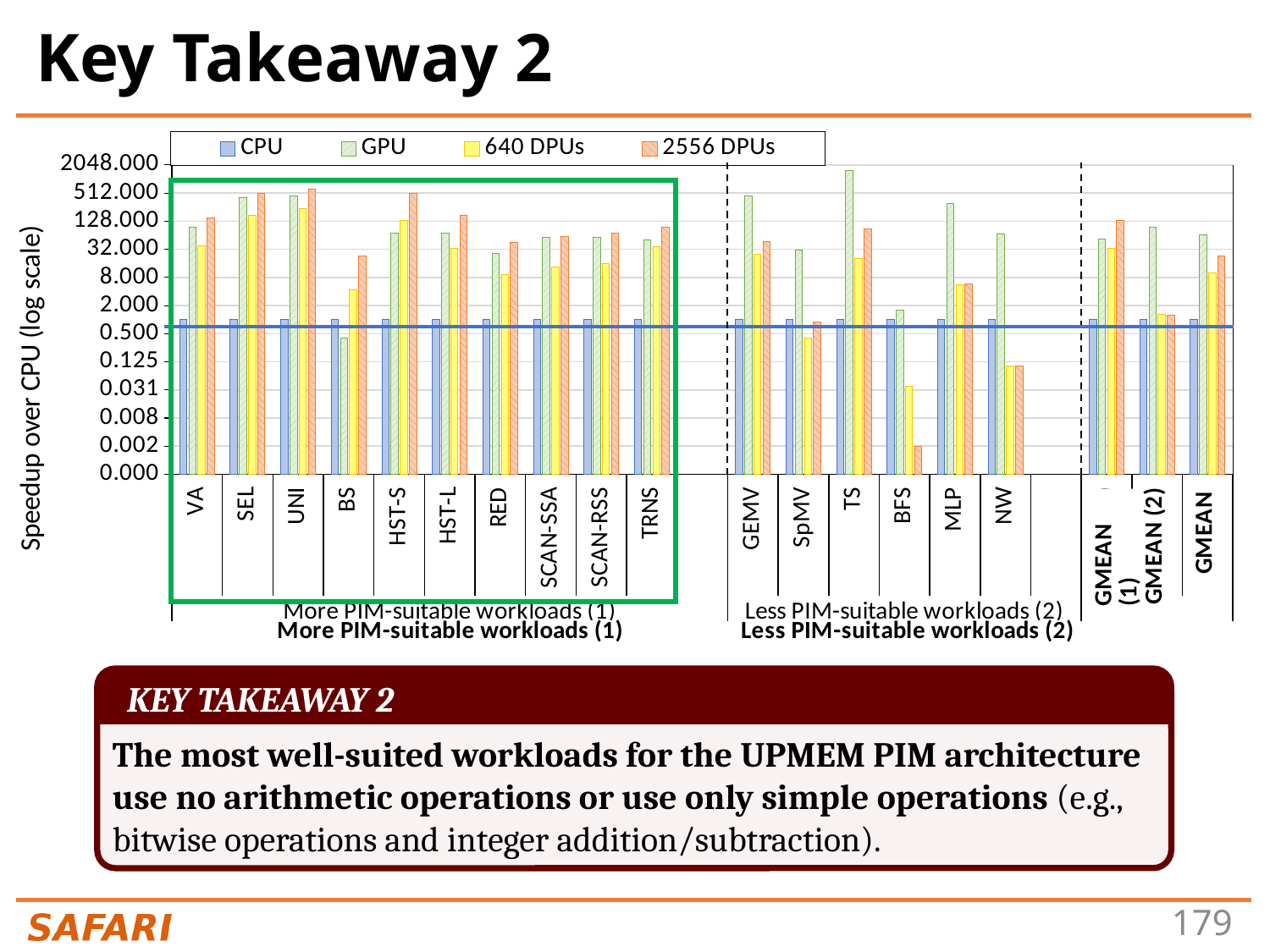
How many workloads are in the 'More PIM-suitable workloads (1)' group? 10 Is the 2556 DPUs value for BFS greater or less than 0.125? less Is the GPU value for TS greater or less than 512? greater How many workloads are in the 'Less PIM-suitable workloads (2)' group? 6 How many series does the legend list? 4 What kind of chart is shown on the slide? bar chart Is the 640 DPUs value for BFS greater or less than 0.125? less For NW, which is larger: the GPU value or the 640 DPUs value? GPU What is the label of the y axis? Speedup over CPU (log scale) For GEMV, which is larger: the GPU value or the 2556 DPUs value? GPU For HST-S, which is larger: the 2556 DPUs value or the GPU value? 2556 DPUs